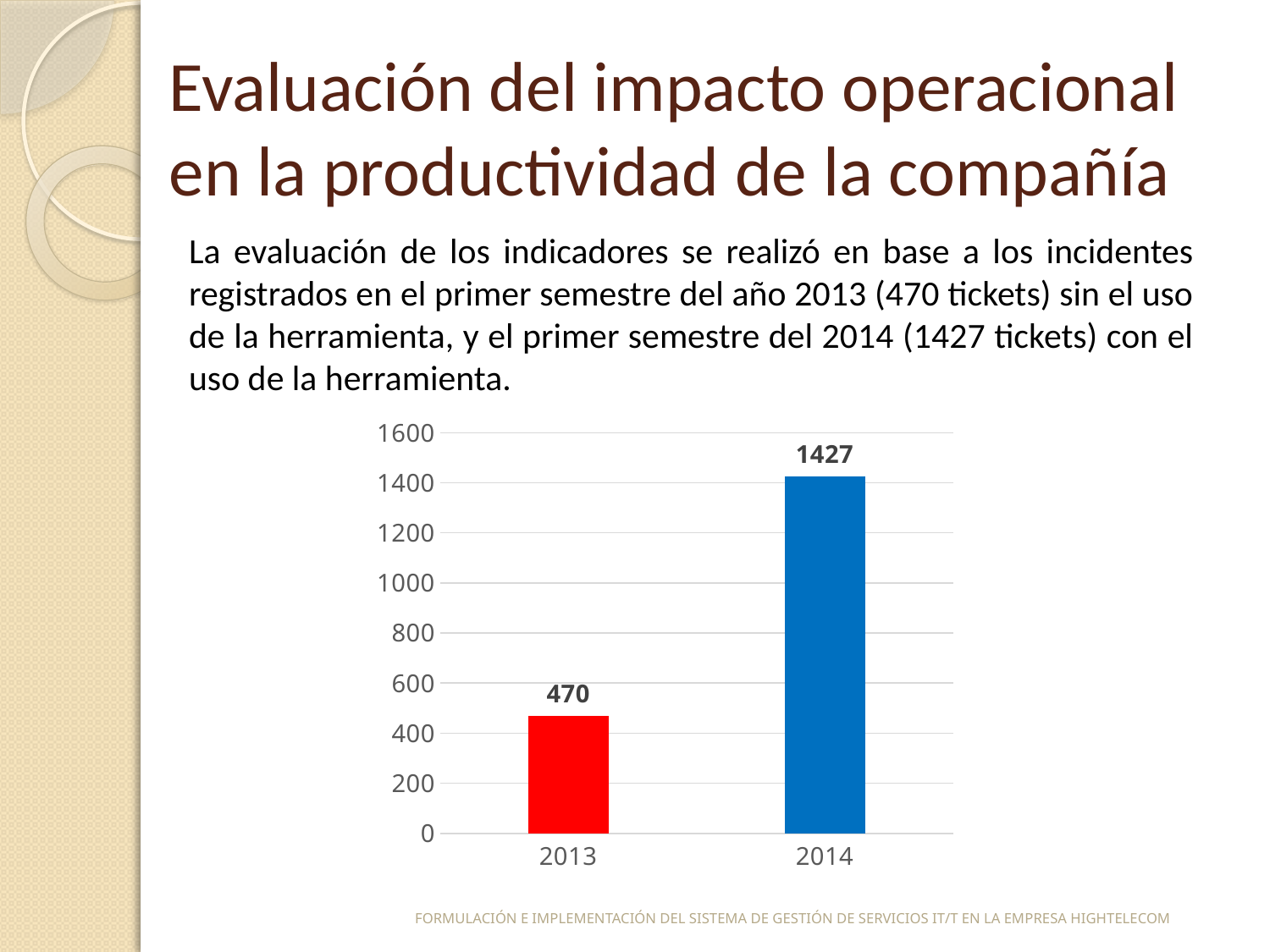
Is the value for 2014 greater or less than 1200? greater Which year has the highest value? 2014 Which is larger, the value for 2013 or the value for 2014? 2014 What is the value for 2014? 1427 What is the value for 2013? 470 Is the value for 2013 greater or less than 600? less How many categories are shown on the x axis? 2 What colour is the bar for 2013? red Do the values rise or fall from 2013 to 2014? rise What is the difference between the values for 2014 and 2013? 957 Which year has the lowest value? 2013 What kind of chart is shown on the slide? bar chart